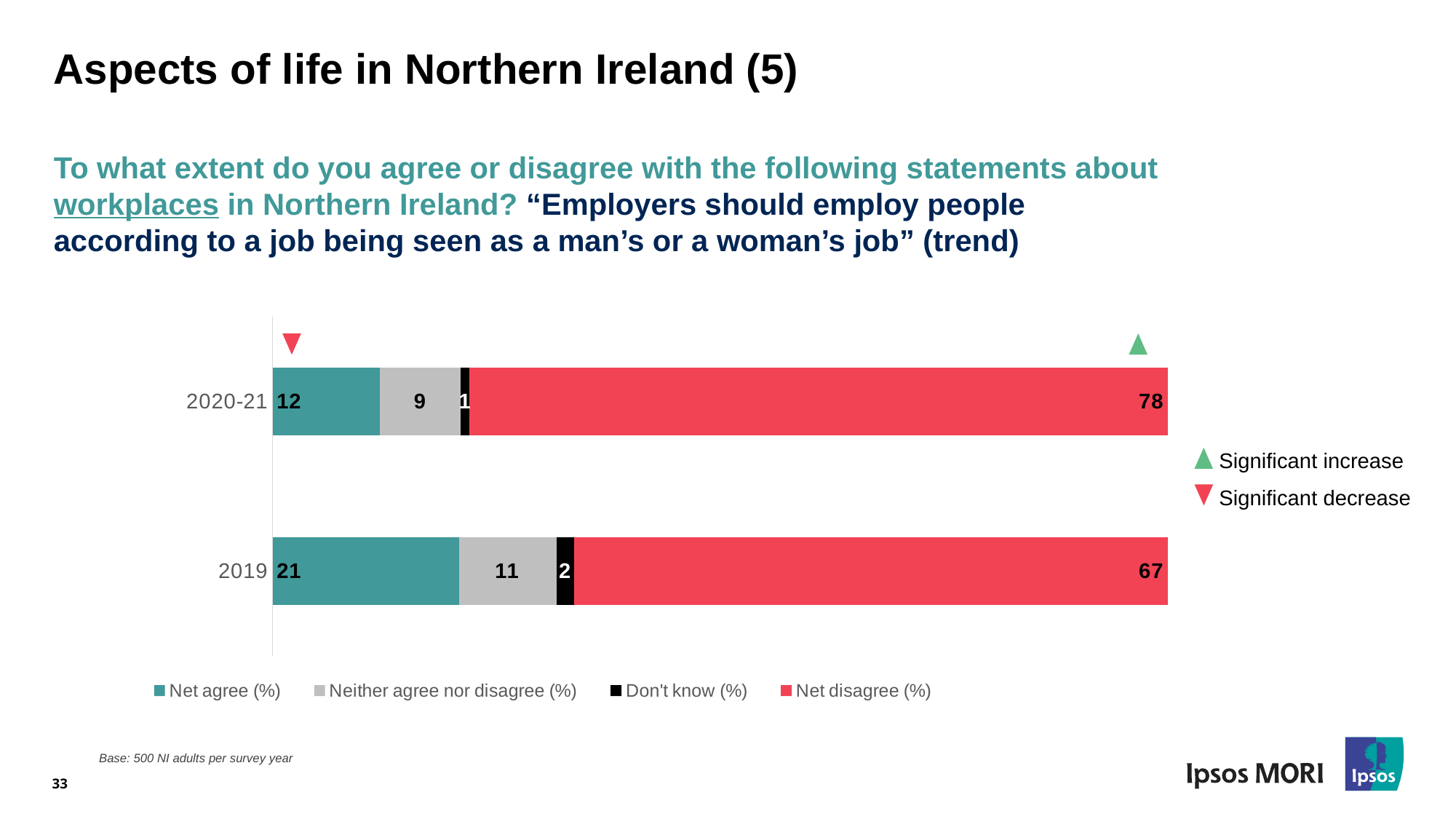
What is the Don't know (%) value for 2019? 2 What is the difference in Net disagree (%) between 2020-21 and 2019? 11 Which year has the higher Net disagree (%) value? 2020-21 What is the Neither agree nor disagree (%) value for 2020-21? 9 How many series does the chart legend list? 4 What is the Net agree (%) value for 2020-21? 12 What is the total of the stacked bar for 2019? 101 Is the Net agree (%) value larger in 2019 or in 2020-21? 2019 Which year has the lower Net agree (%) value? 2020-21 What kind of chart is shown on the slide? Stacked bar chart How many years (categories) are shown in the chart? 2 What is the Net disagree (%) value for 2019? 67